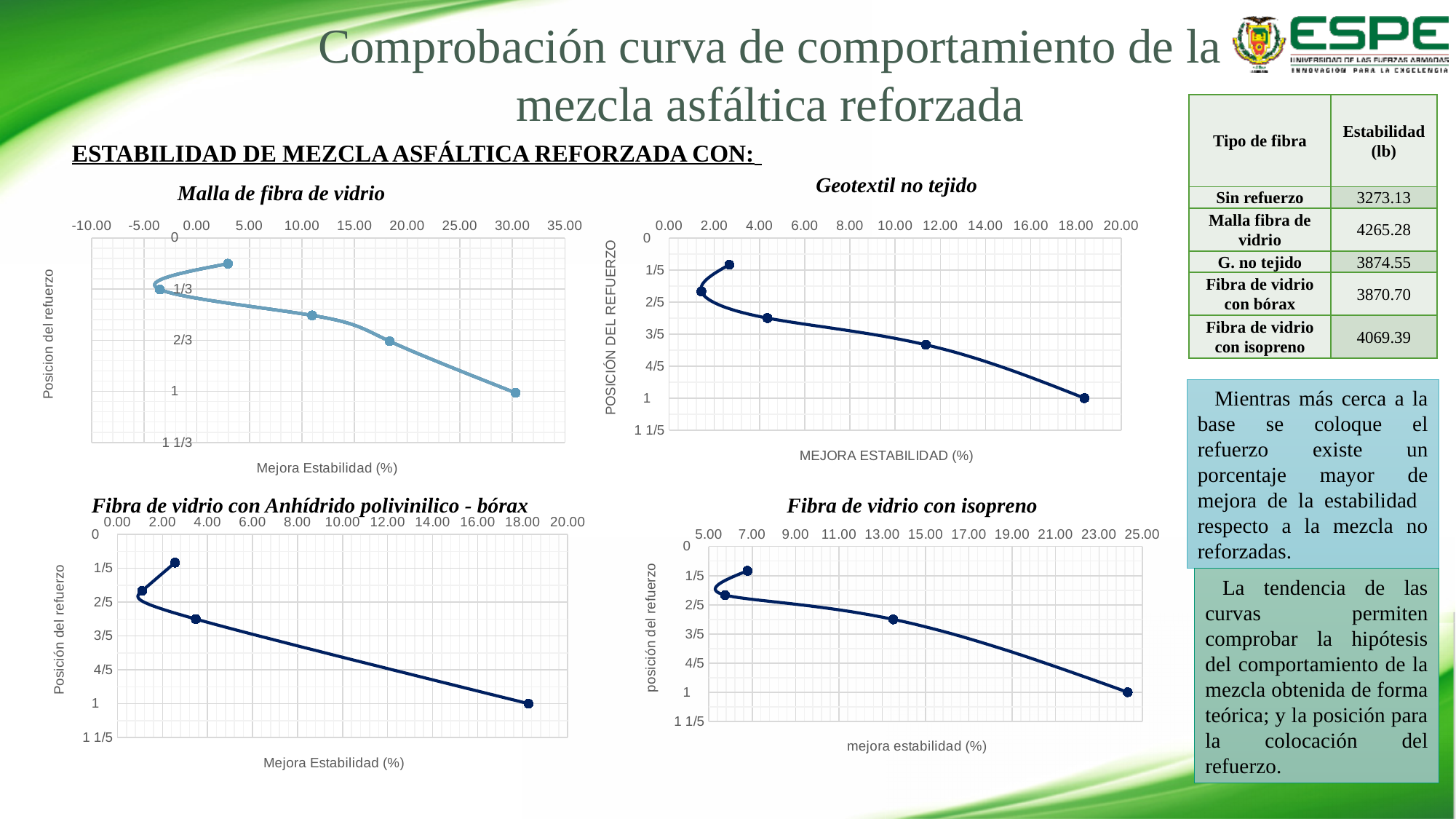
How many data points are plotted on the 'Malla de fibra de vidrio' chart? 5 On the 'Fibra de vidrio con Anhídrido polivinilico - bórax' chart, is the improvement value at position 1 greater or less than 16.00? greater What kind of chart is the 'Malla de fibra de vidrio' chart? line chart What is the x-axis title of the 'Geotextil no tejido' chart? MEJORA ESTABILIDAD (%) On the 'Malla de fibra de vidrio' chart, which reinforcement position has the highest stability improvement? 1 How many data points are plotted on the 'Geotextil no tejido' chart? 5 How many data points are plotted on the 'Fibra de vidrio con Anhídrido polivinilico - bórax' chart? 4 On the 'Malla de fibra de vidrio' chart, is the improvement value at position 1 greater or less than 25.00? greater On the 'Fibra de vidrio con isopreno' chart, is the improvement value at position 1 greater or less than 21.00? greater